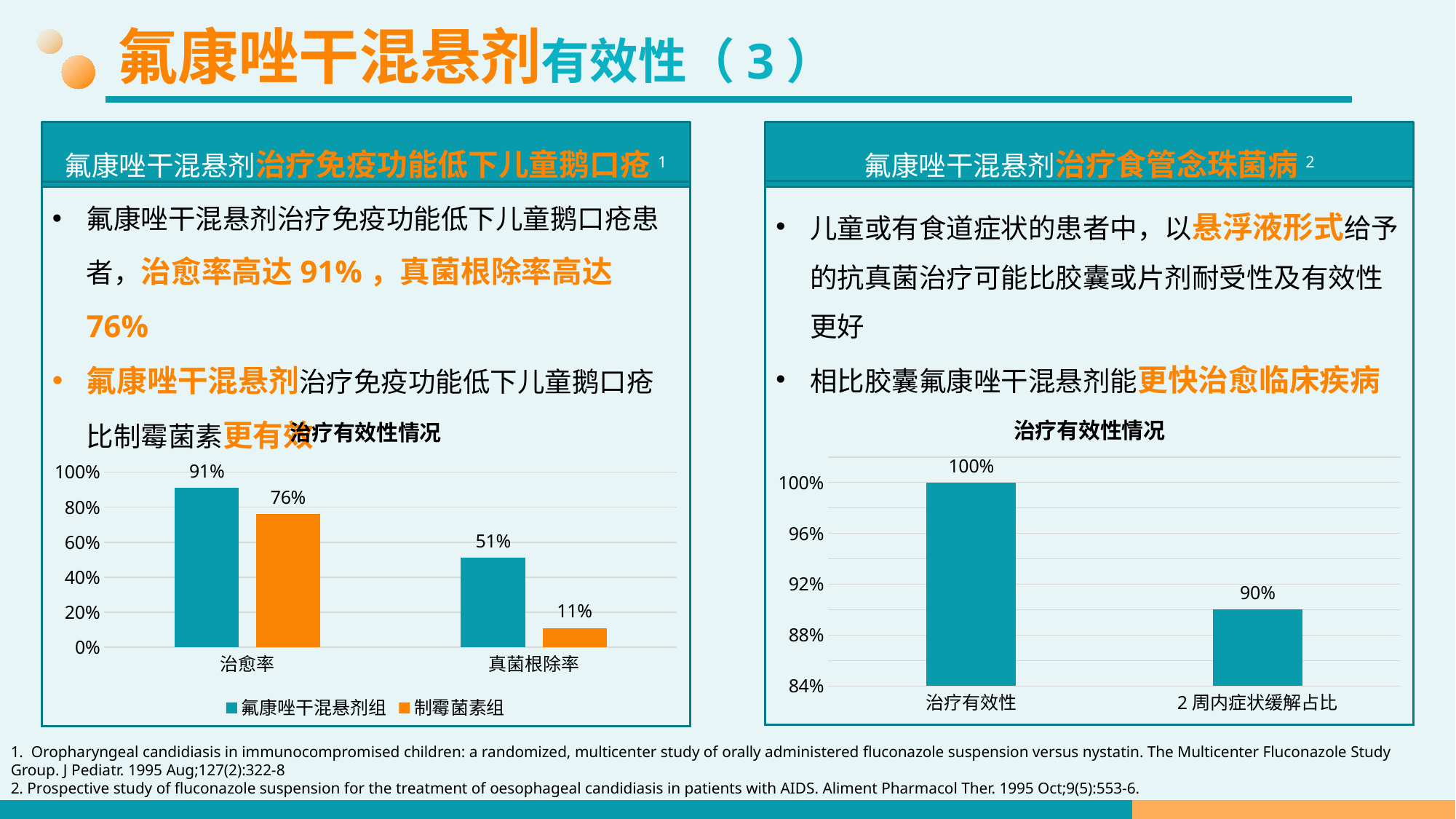
In the left chart, what is the difference between 氟康唑干混悬剂组 and 制霉菌素组 in the 治愈率 category? 15% In the right chart, how many categories are shown on the x axis? 2 In the left chart, what is the value for 氟康唑干混悬剂组 in the 治愈率 category? 91% What kind of chart is the left chart? Bar chart In the right chart, what is the value for 治疗有效性? 100% In the right chart, what is the difference between 治疗有效性 and 2 周内症状缓解占比? 10% In the left chart, which bar has the lowest value? 制霉菌素组 in 真菌根除率 (11%) In the left chart, what is the value for 制霉菌素组 in the 真菌根除率 category? 11% In the left chart, how many series does the legend list? 2 In the left chart, which series has the higher value in the 真菌根除率 category? 氟康唑干混悬剂组 In the right chart, what is the value for 2 周内症状缓解占比? 90% In the left chart, what is the value for 氟康唑干混悬剂组 in the 真菌根除率 category? 51%